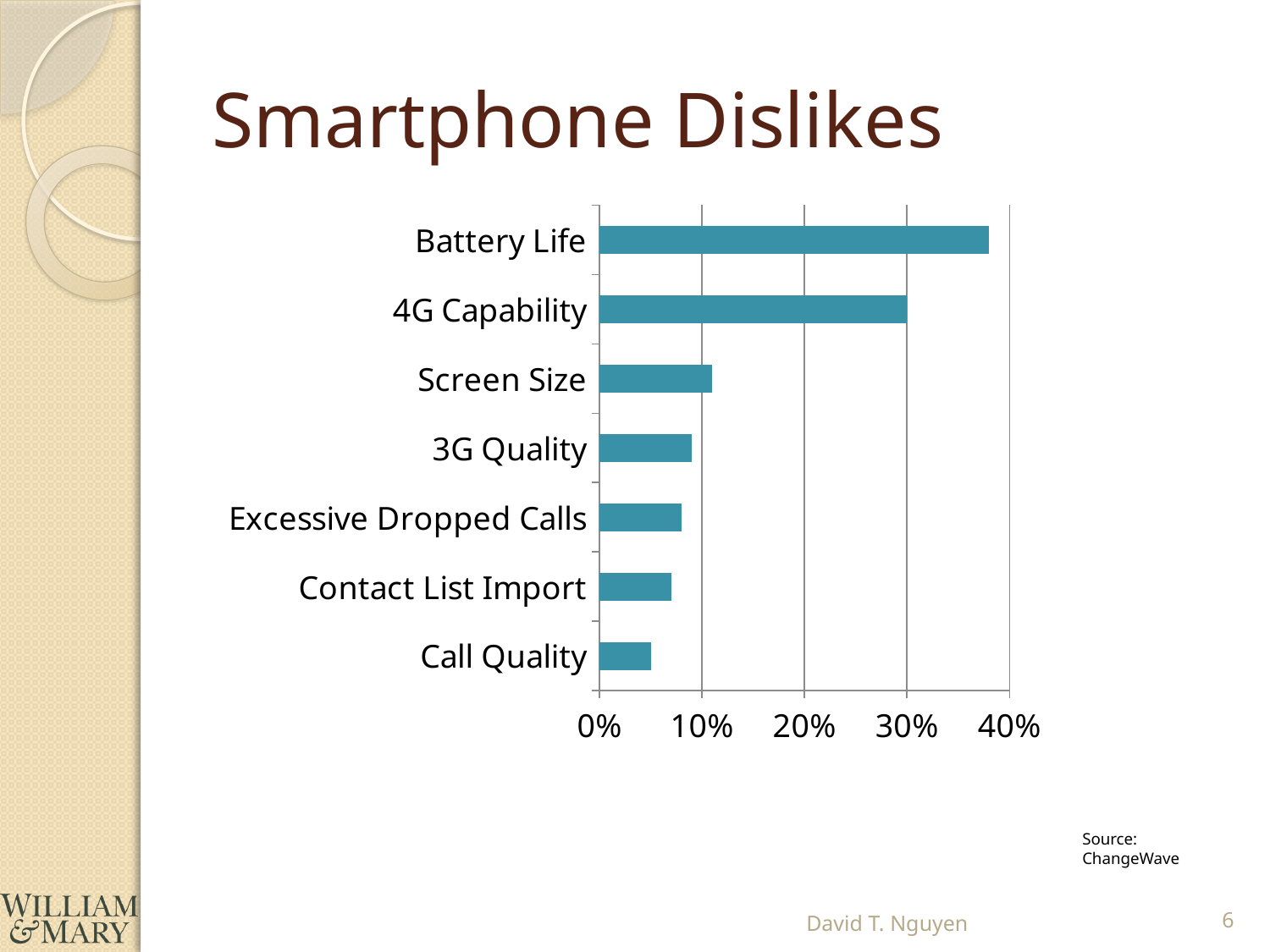
What is the title of the chart on the slide? Smartphone Dislikes How many categories are shown in the Smartphone Dislikes chart? 7 Which is larger, the value for Screen Size or the value for Call Quality? Screen Size Is the value for Battery Life greater or less than 30%? greater Is the value for Call Quality greater or less than 10%? less What is the highest value shown on the horizontal axis of the chart? 40% Which category has the lowest value in the Smartphone Dislikes chart? Call Quality Which category has the highest value in the Smartphone Dislikes chart? Battery Life Is the value for 4G Capability greater or less than 20%? greater Which is larger, the value for 4G Capability or the value for Screen Size? 4G Capability What kind of chart is shown on the slide? Bar chart